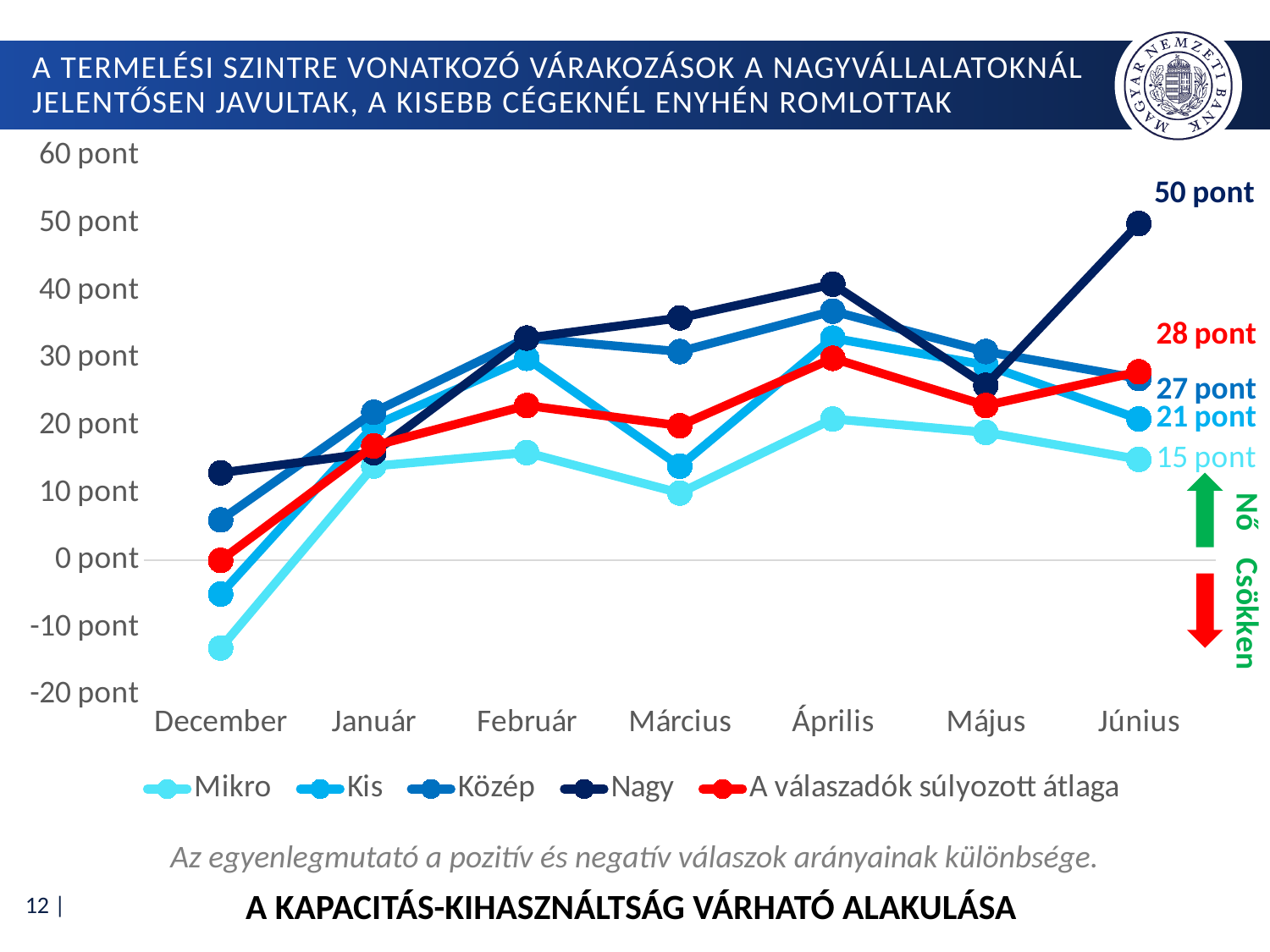
Which series has the highest value in Június? Nagy What is the value for Nagy in Június? 50 pont Is the value for Nagy in Április greater or less than 30 pont? greater What is the value for A válaszadók súlyozott átlaga in Június? 28 pont Which series has the lowest value in Június? Mikro What is the difference between the Nagy and Mikro values in Június? 35 pont Does the Mikro series rise or fall from December to Január? rise In Június, which is larger: Kis or Közép? Közép How many months are shown on the x axis? 7 What kind of chart is shown on the slide? line chart How many series does the legend list? 5 What is the value for Mikro in Június? 15 pont